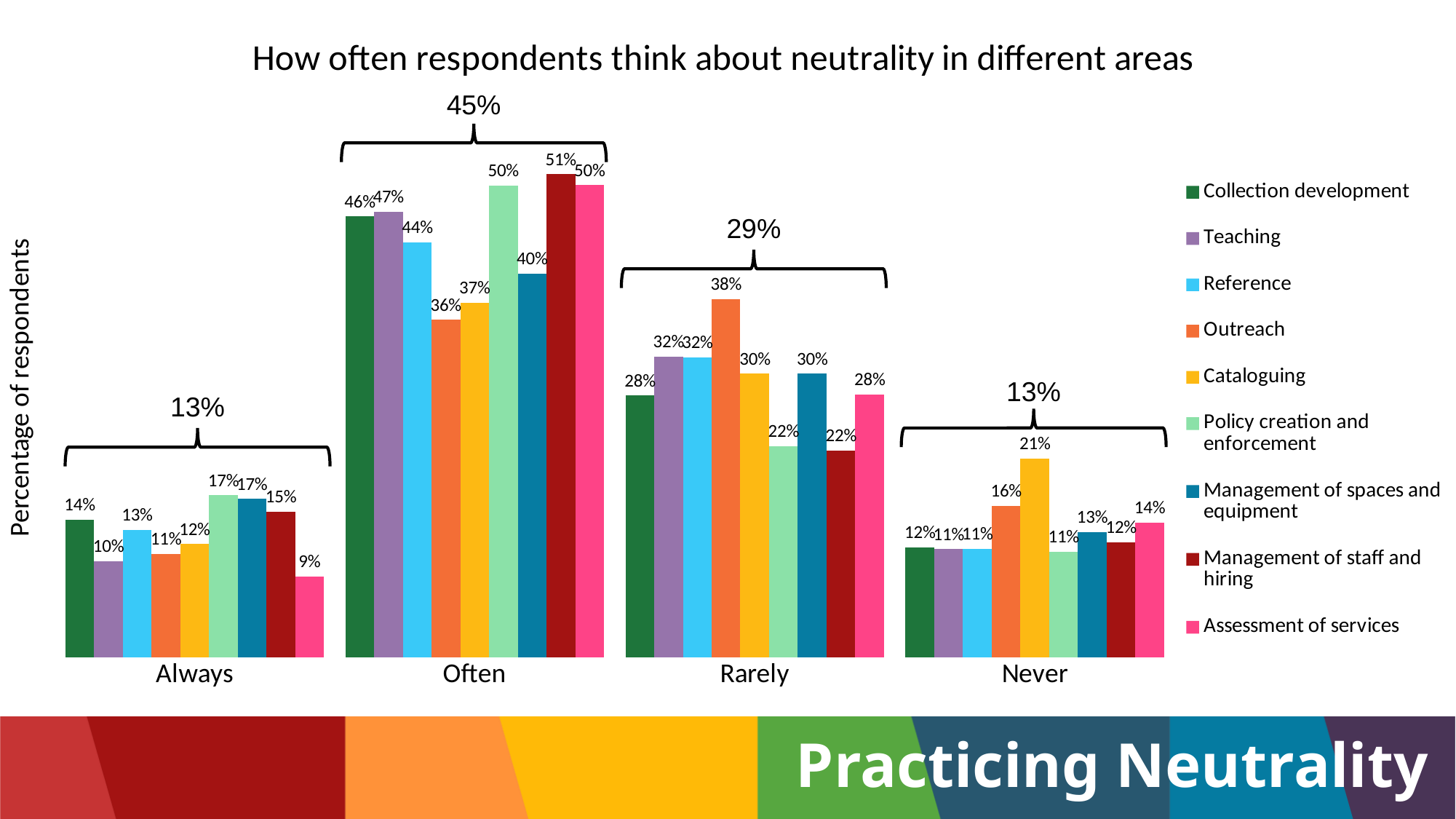
Which area has the highest value in the 'Rarely' group? Outreach What kind of chart is shown on the slide? Bar chart In the 'Never' group, is the value for Cataloguing or Outreach larger? Cataloguing Which area has the highest value in the 'Often' group? Management of staff and hiring How many series does the legend list? 9 What is the value for Cataloguing in the 'Never' group? 21% What is the difference between the Outreach and Collection development values in the 'Rarely' group? 10% What is the value for Assessment of services in the 'Always' group? 9% What overall percentage is shown above the bracket for the 'Often' group? 45% Which area has the lowest value in the 'Always' group? Assessment of services What percentage of respondents said they think about neutrality in Outreach 'Often'? 36% How many response categories are shown along the x axis? 4